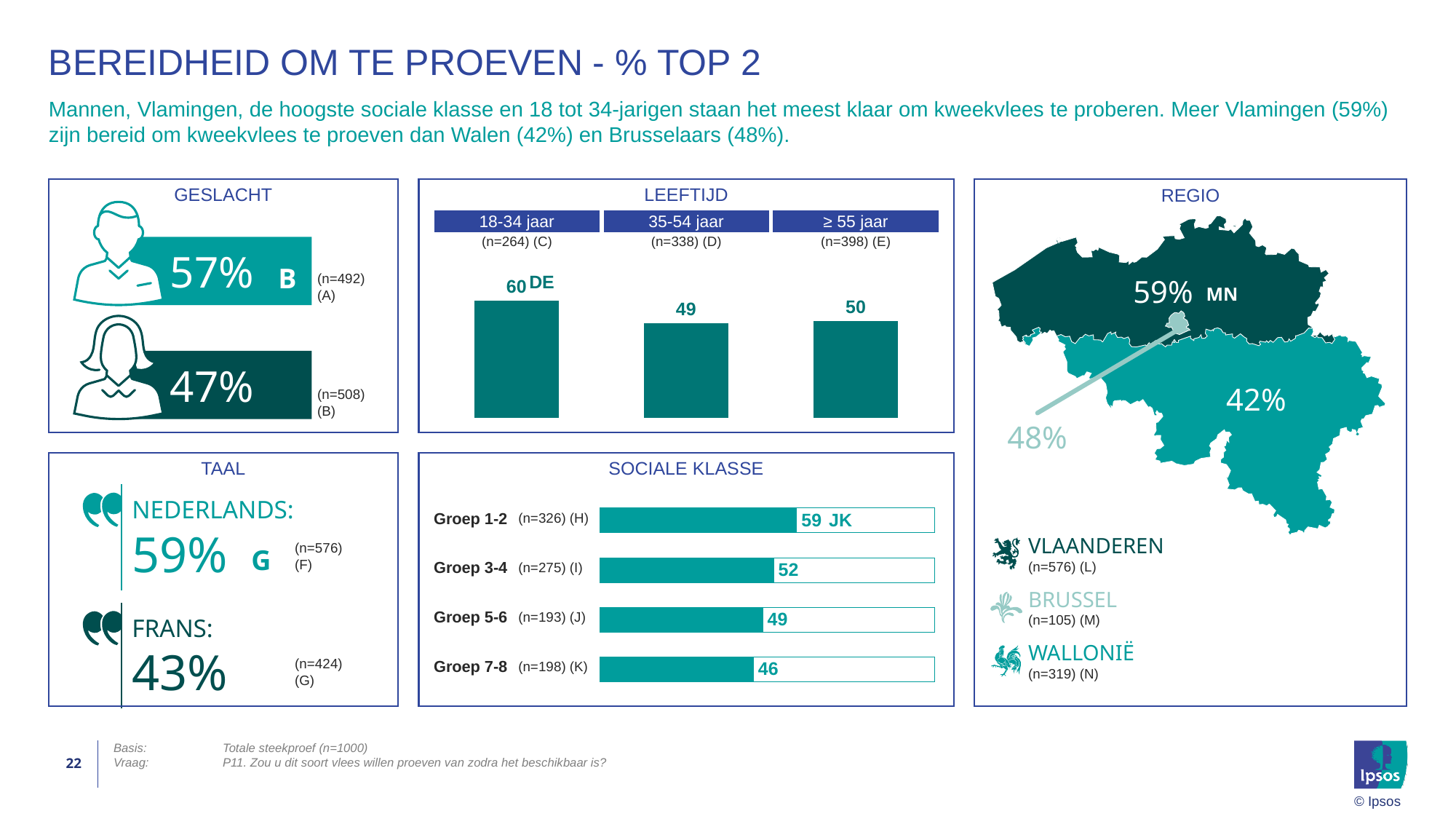
In the SOCIALE KLASSE chart, which group has the lowest value? Groep 7-8 In the SOCIALE KLASSE chart, which is larger: the value for Groep 1-2 or Groep 5-6? Groep 1-2 In the SOCIALE KLASSE chart, what is the difference between the values for Groep 1-2 and Groep 7-8? 13 In the LEEFTIJD chart, which age group has the highest value? 18-34 jaar What kind of chart is the LEEFTIJD chart? Bar chart In the SOCIALE KLASSE chart, what is the value for Groep 3-4? 52 In the SOCIALE KLASSE chart, what is the value for Groep 7-8? 46 In the LEEFTIJD chart, how many age groups are shown? 3 In the LEEFTIJD chart, what is the value for 35-54 jaar? 49 In the SOCIALE KLASSE chart, do the values rise or fall from Groep 1-2 down to Groep 7-8? Fall In the LEEFTIJD chart, what is the difference between the values for 18-34 jaar and ≥ 55 jaar? 10 In the LEEFTIJD chart, what is the value for 18-34 jaar? 60